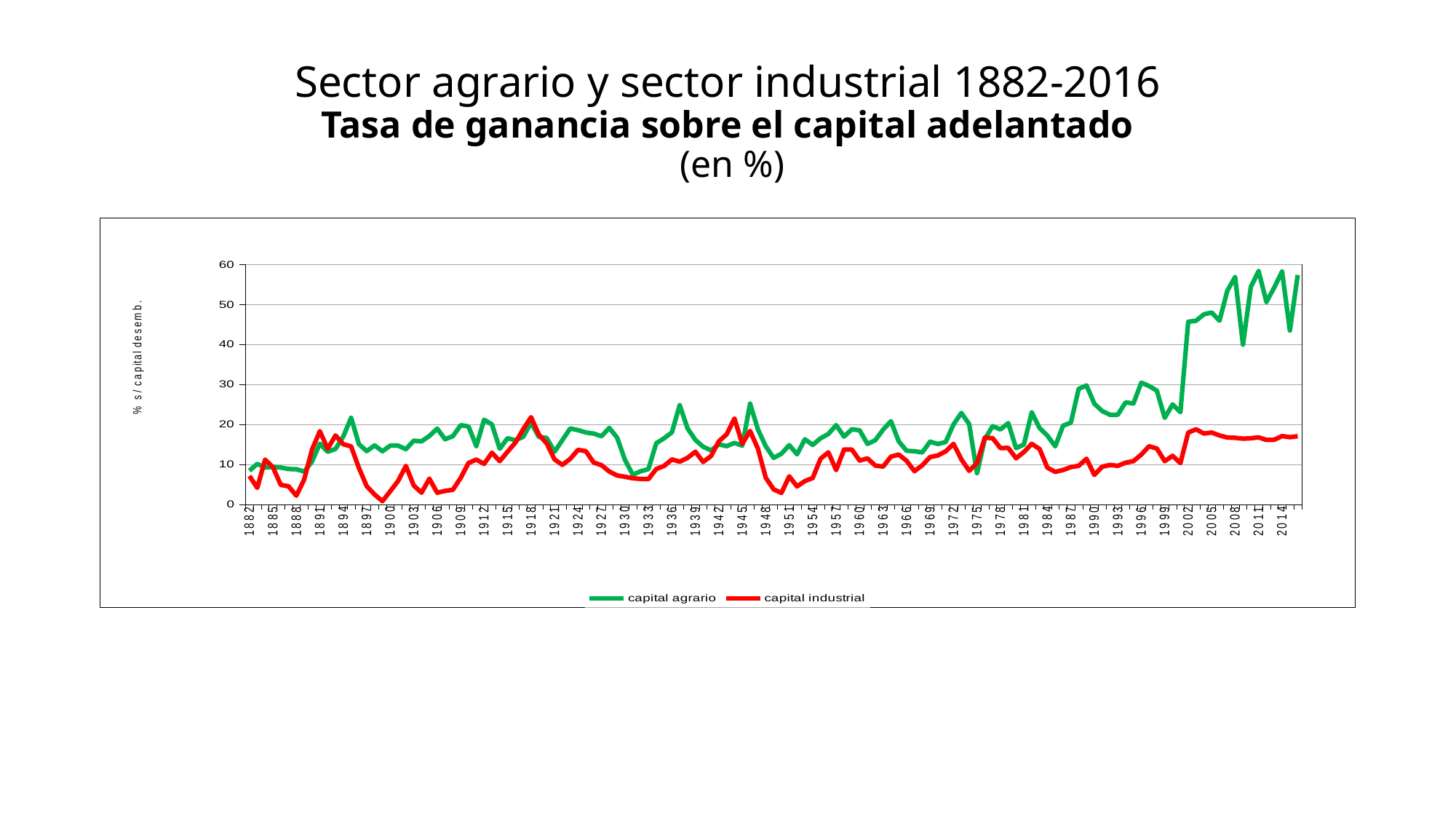
What are the two series named in the legend? capital agrario and capital industrial Is the value for capital industrial in 1951 greater or less than 10? less Is the value for capital agrario in 2005 greater or less than 40? greater Does the capital agrario line rise or fall between 1999 and 2002? rise Is the value for capital industrial in 1900 greater or less than 10? less In 2008, which series has the higher value, capital agrario or capital industrial? capital agrario What colour is the capital industrial line? red Which series reaches the highest value anywhere on the chart? capital agrario How many series does the legend list? 2 What kind of chart is shown on the slide? line chart